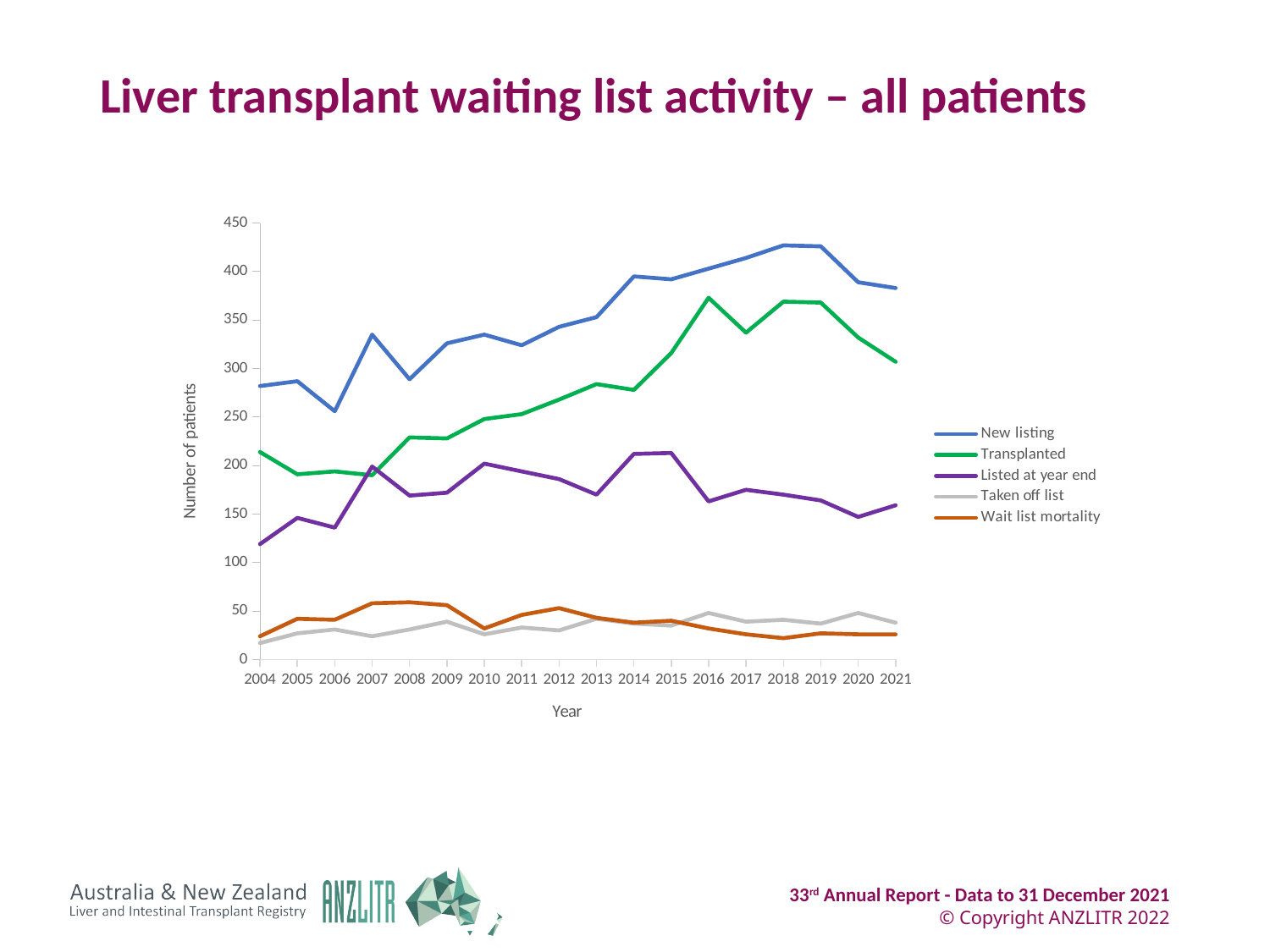
In which year is the Listed at year end series at its lowest? 2004 Is the value for New listing in 2018 greater or less than 400? greater How many series does the legend list? 5 Is the value for Transplanted in 2021 greater or less than 350? less Does the New listing series overall rise or fall from 2004 to 2021? rise In which year is the New listing series at its lowest? 2006 Is the value for Taken off list in 2004 greater or less than 50? less How many years are plotted along the x axis? 18 In 2016, which is larger: Transplanted or Listed at year end? Transplanted In 2008, which is larger: Wait list mortality or Taken off list? Wait list mortality What kind of chart is shown on the slide? line chart